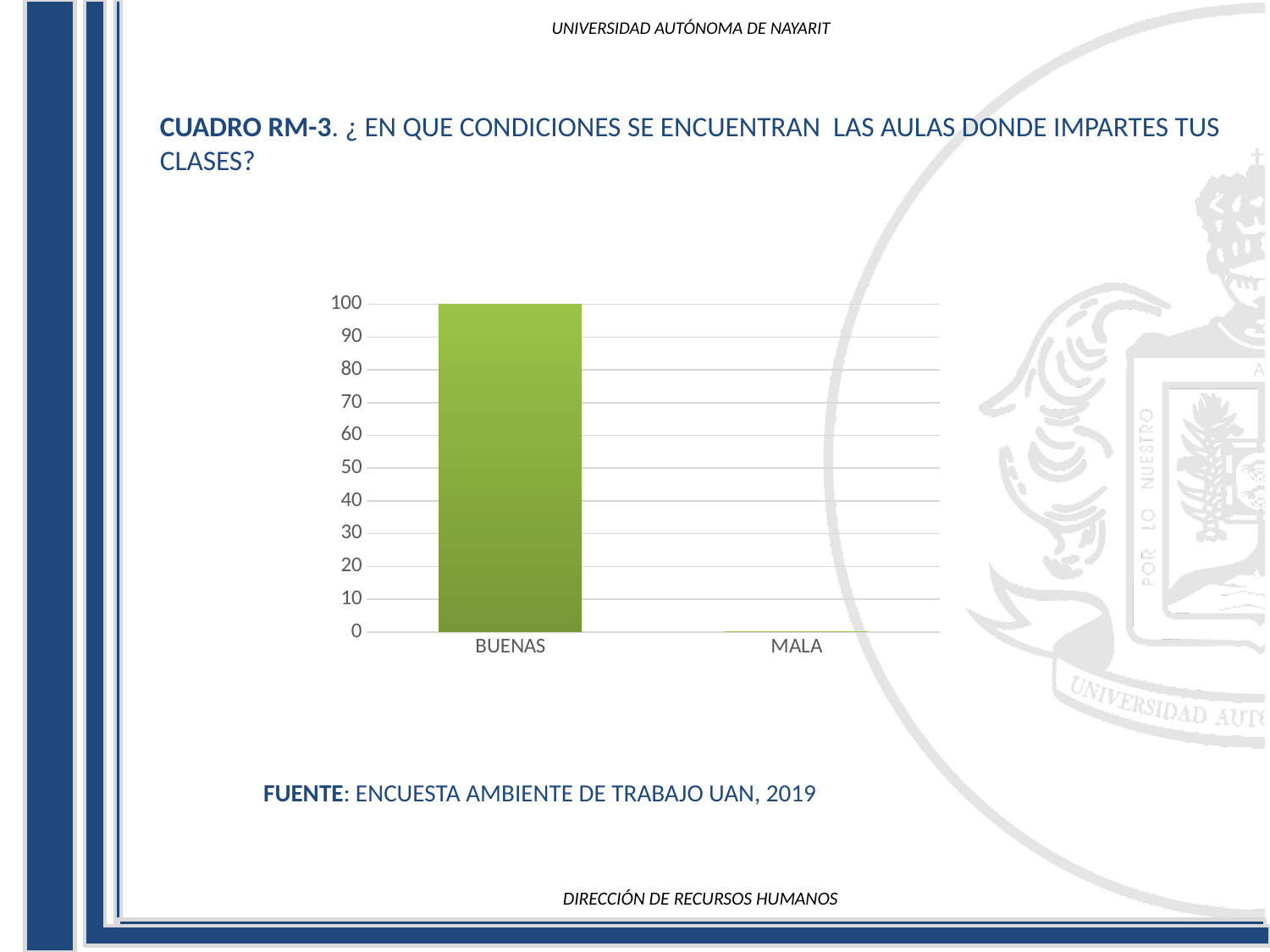
How many categories are shown on the x axis of the chart? 2 Which is larger, the value for BUENAS or the value for MALA? BUENAS What is the highest tick value shown on the vertical axis of the chart? 100 Is the value for BUENAS greater or less than 90? greater What is the value for BUENAS in the chart? 100 Is the value for MALA greater or less than 10? less What kind of chart is shown on the slide? bar chart Which category has the lowest value in the chart? MALA Which category has the highest value in the chart? BUENAS What source is cited below the chart? ENCUESTA AMBIENTE DE TRABAJO UAN, 2019 Do the values rise or fall from left to right along the x axis? fall